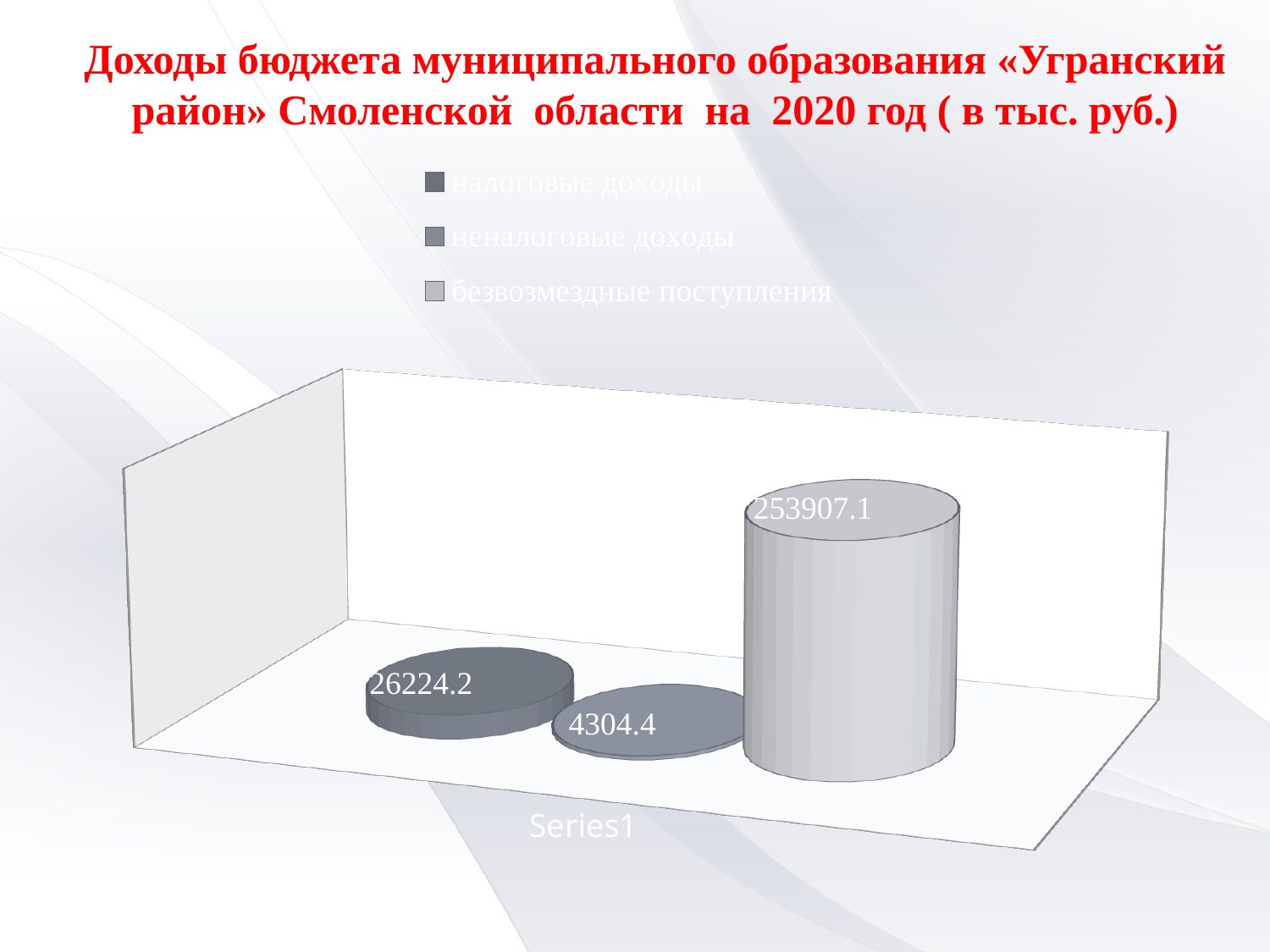
What year does the chart title refer to? 2020 Which series has the lowest value? неналоговые доходы What is the value for безвозмездные поступления? 253907.1 What is the value for налоговые доходы? 26224.2 What is the difference between налоговые доходы and неналоговые доходы? 21919.8 Which is larger, налоговые доходы or неналоговые доходы? налоговые доходы How many series does the legend list? 3 What is the difference between безвозмездные поступления and налоговые доходы? 227682.9 What is the value for неналоговые доходы? 4304.4 What kind of chart is shown on the slide? bar chart What is the category label shown on the x axis? Series1 Which series has the highest value? безвозмездные поступления